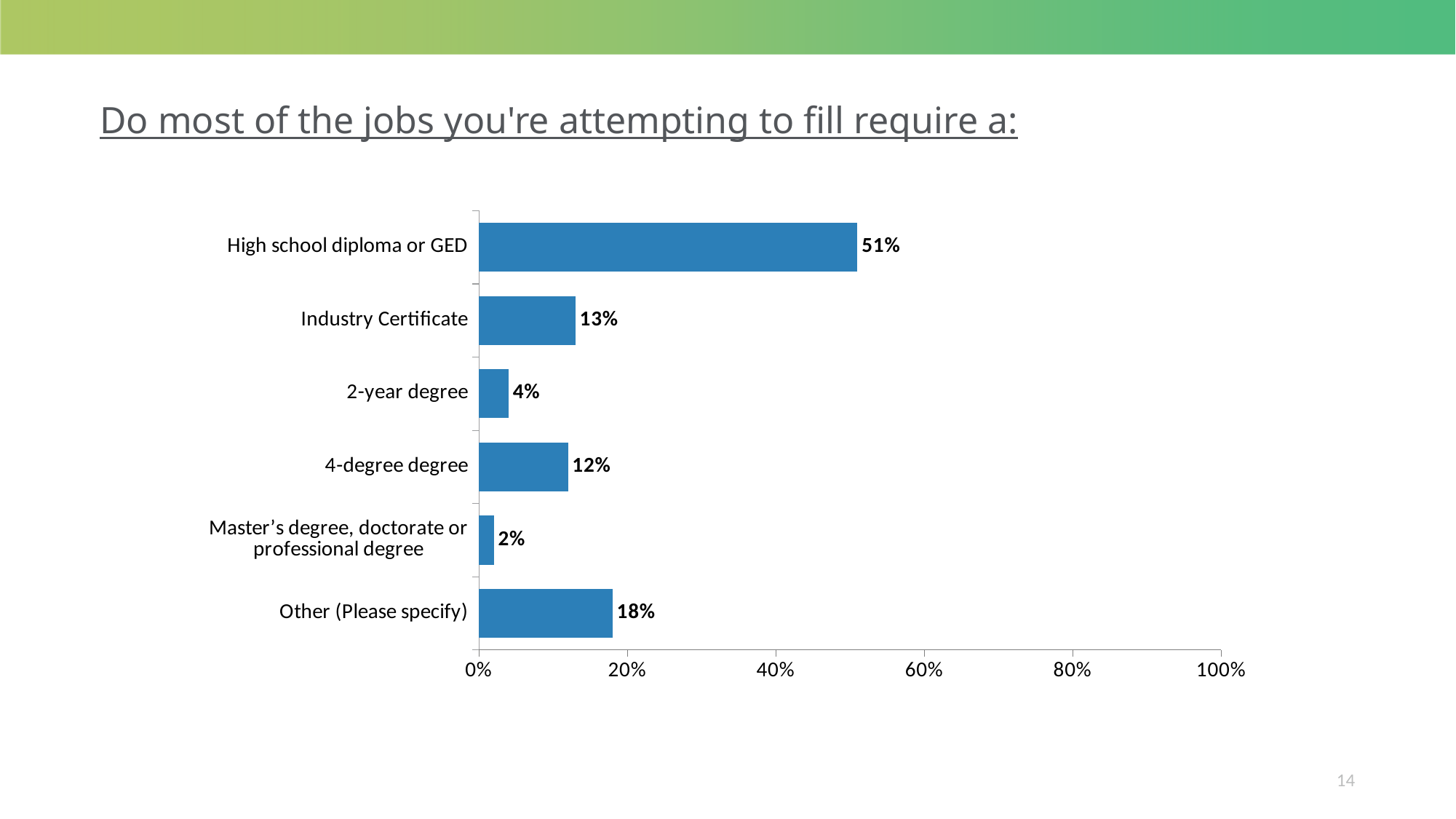
What is the title of the slide? Do most of the jobs you're attempting to fill require a: What is the difference between the values for High school diploma or GED and Other (Please specify)? 33% Is the value for High school diploma or GED greater or less than 40%? greater Which category has the highest value? High school diploma or GED What is the value shown for Industry Certificate? 13% What kind of chart is shown on the slide? Bar chart What is the value shown for Other (Please specify)? 18% Which is larger, the value for Industry Certificate or the value for 4-degree degree? Industry Certificate Which category has the lowest value? Master's degree, doctorate or professional degree How many categories are shown in the chart? 6 What percentage of respondents said most jobs require a high school diploma or GED? 51% What is the value shown for 4-degree degree? 12%